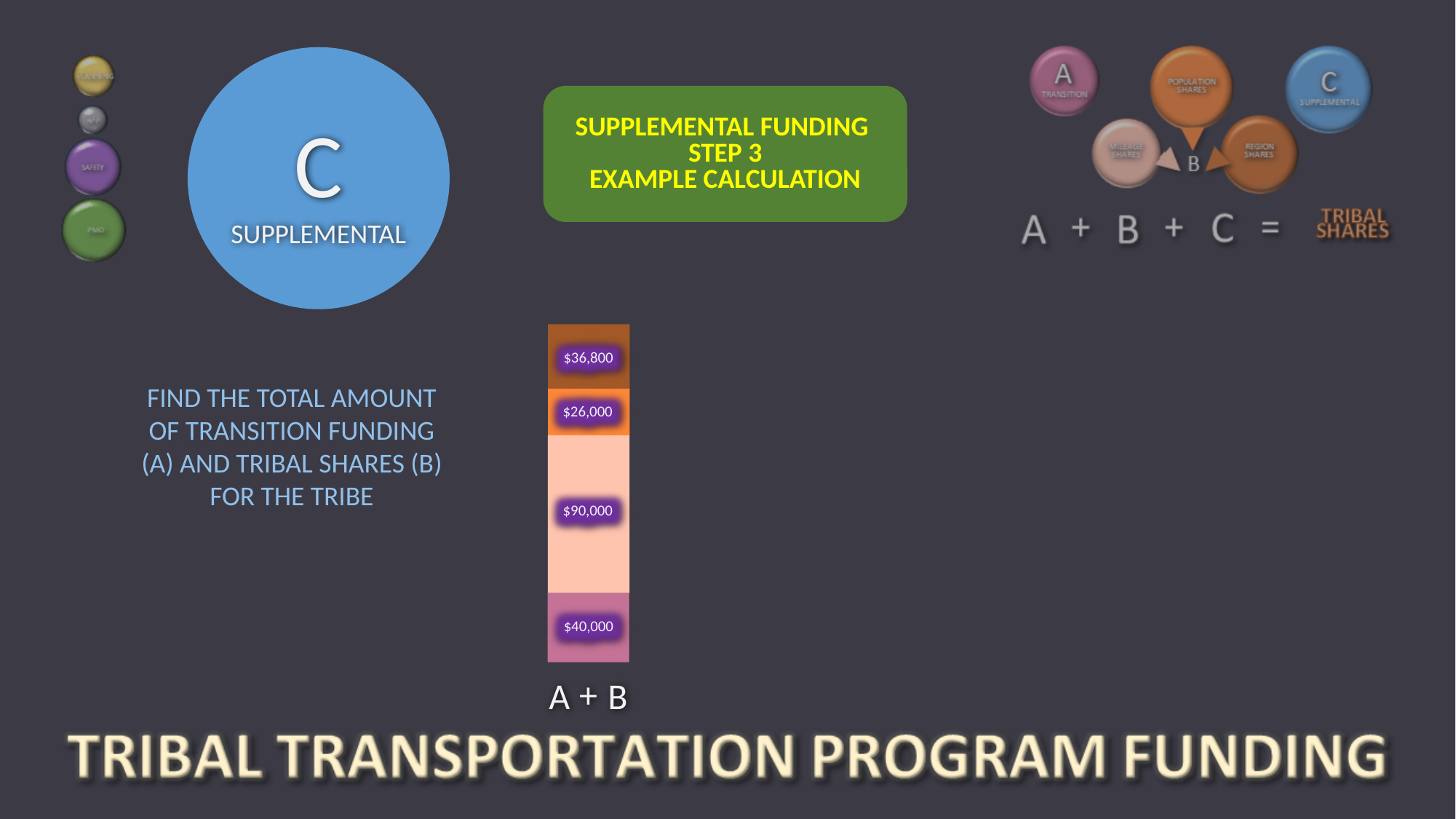
What value is printed on the bottom (pink) segment of the stacked bar? $40,000 What is the total of all four segments in the A + B stacked bar? $192,800 What is the difference between the largest segment ($90,000) and the smallest segment ($26,000) in the stacked bar? $64,000 Which is larger in the stacked bar: the top brown segment or the bottom pink segment? the bottom pink segment ($40,000) What value is printed on the orange segment, second from the top, of the stacked bar? $26,000 How many segments make up the stacked bar labelled A + B? 4 Which segment of the stacked bar has the smallest value? $26,000 (orange segment) What type of chart is shown on the slide? bar chart Which segment of the stacked bar has the largest value? $90,000 (peach segment) What value is printed on the large peach-coloured segment of the stacked bar? $90,000 What is the category label printed beneath the stacked bar? A + B What value is printed on the topmost (brown) segment of the stacked bar? $36,800